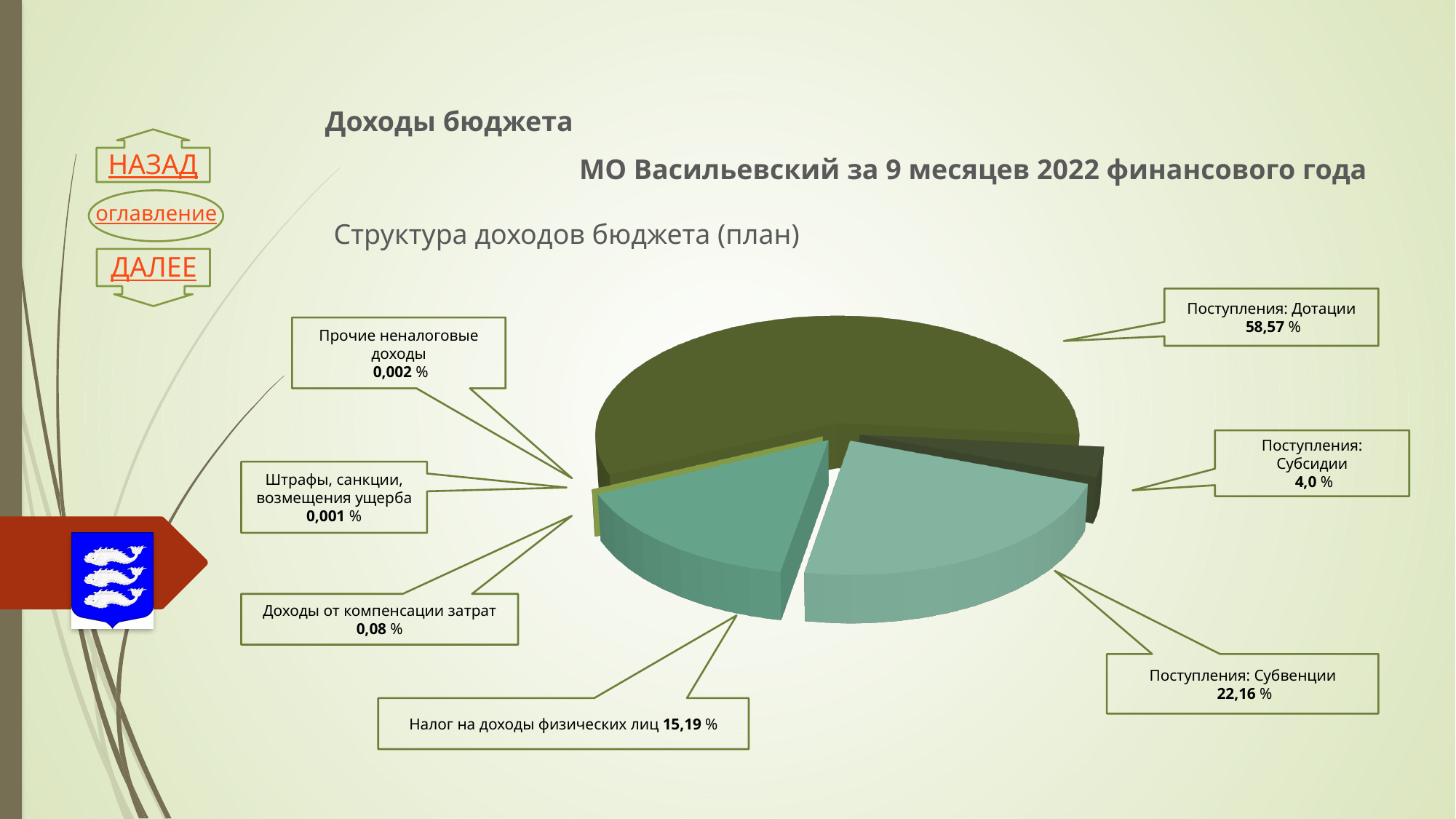
How many categories are labelled on the pie chart? 7 What kind of chart is shown on the slide? Pie chart What is the share for Поступления: Дотации? 58,57 % What is the share for Штрафы, санкции, возмещения ущерба? 0,001 % Which category has the largest share of the pie? Поступления: Дотации What is the share for Поступления: Субсидии? 4,0 % Which category has the smallest share of the pie? Штрафы, санкции, возмещения ущерба What is the share for Налог на доходы физических лиц? 15,19 % What is the share for Доходы от компенсации затрат? 0,08 % What is the title of the chart? Структура доходов бюджета (план) What is the share for Поступления: Субвенции? 22,16 % Which is larger: Поступления: Субвенции or Налог на доходы физических лиц? Поступления: Субвенции